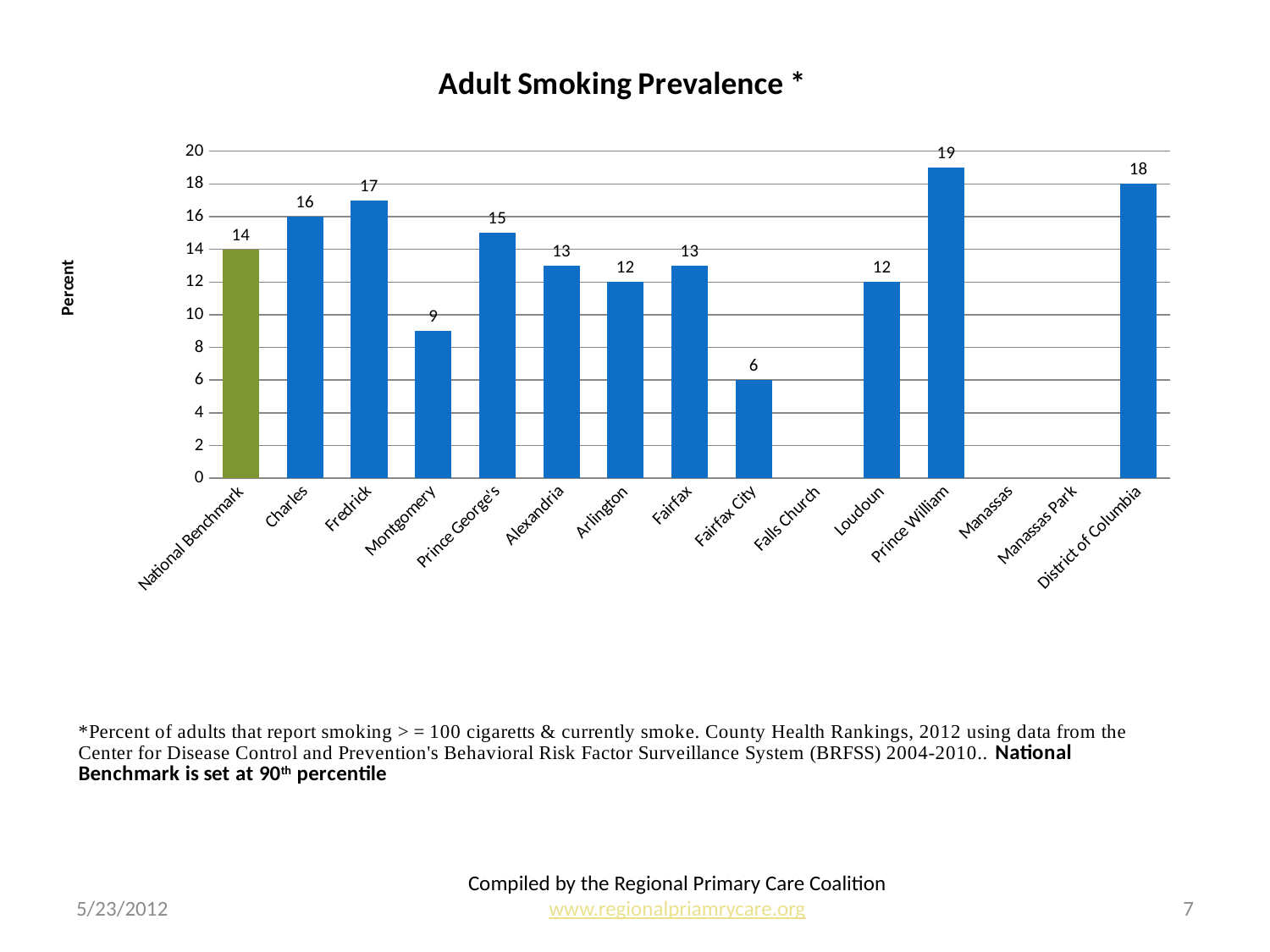
Is the value for Fredrick greater or less than the National Benchmark value of 14? greater Among the categories with a plotted bar, which has the lowest value? Fairfax City What is the value shown for Fairfax City? 6 Which has a higher value, Charles or Prince George's? Charles What type of chart is shown on the slide? bar chart What is the title of the chart? Adult Smoking Prevalence * What is the adult smoking prevalence value shown for Prince William? 19 What value is shown for the National Benchmark bar? 14 How many category labels are shown on the x axis? 15 Which category has the highest adult smoking prevalence? Prince William Which bar is coloured green rather than blue? National Benchmark What is the difference between the values for District of Columbia and Montgomery? 9